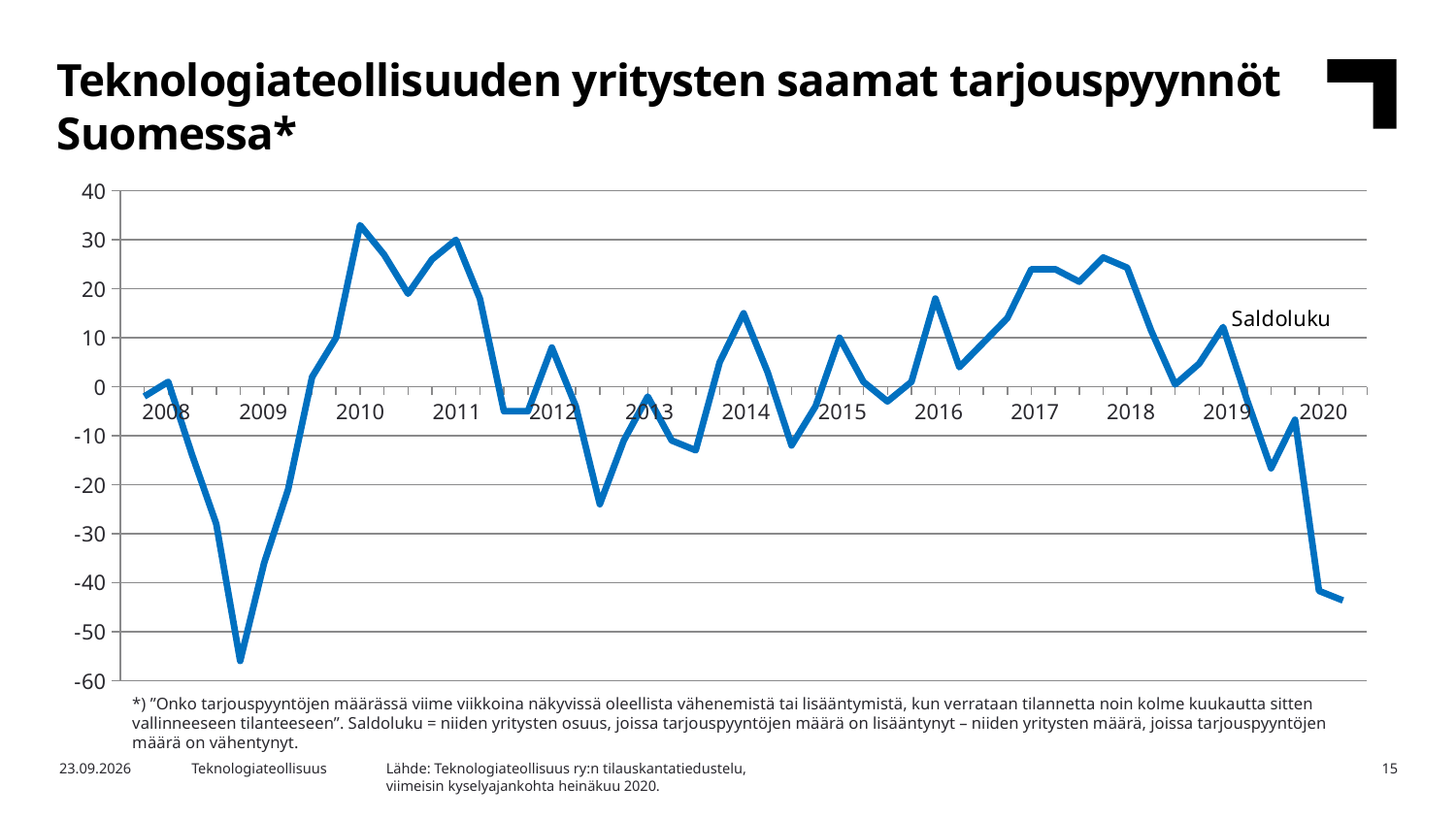
How many year labels are shown on the x axis? 13 Is the highest value of the line around 2017–2018 greater or less than 20? greater Does the line rise or fall between 2018 and 2020? fall How many series does the chart plot? 1 What is the name of the series plotted in the chart? Saldoluku Is the peak value of the line in 2010 greater or less than 30? greater What kind of chart is shown on the slide? line chart Does the line rise or fall between 2009 and 2010? rise Is the final value of the line in 2020 greater or less than -40? less What is the title of the chart on the slide? Teknologiateollisuuden yritysten saamat tarjouspyynnöt Suomessa*